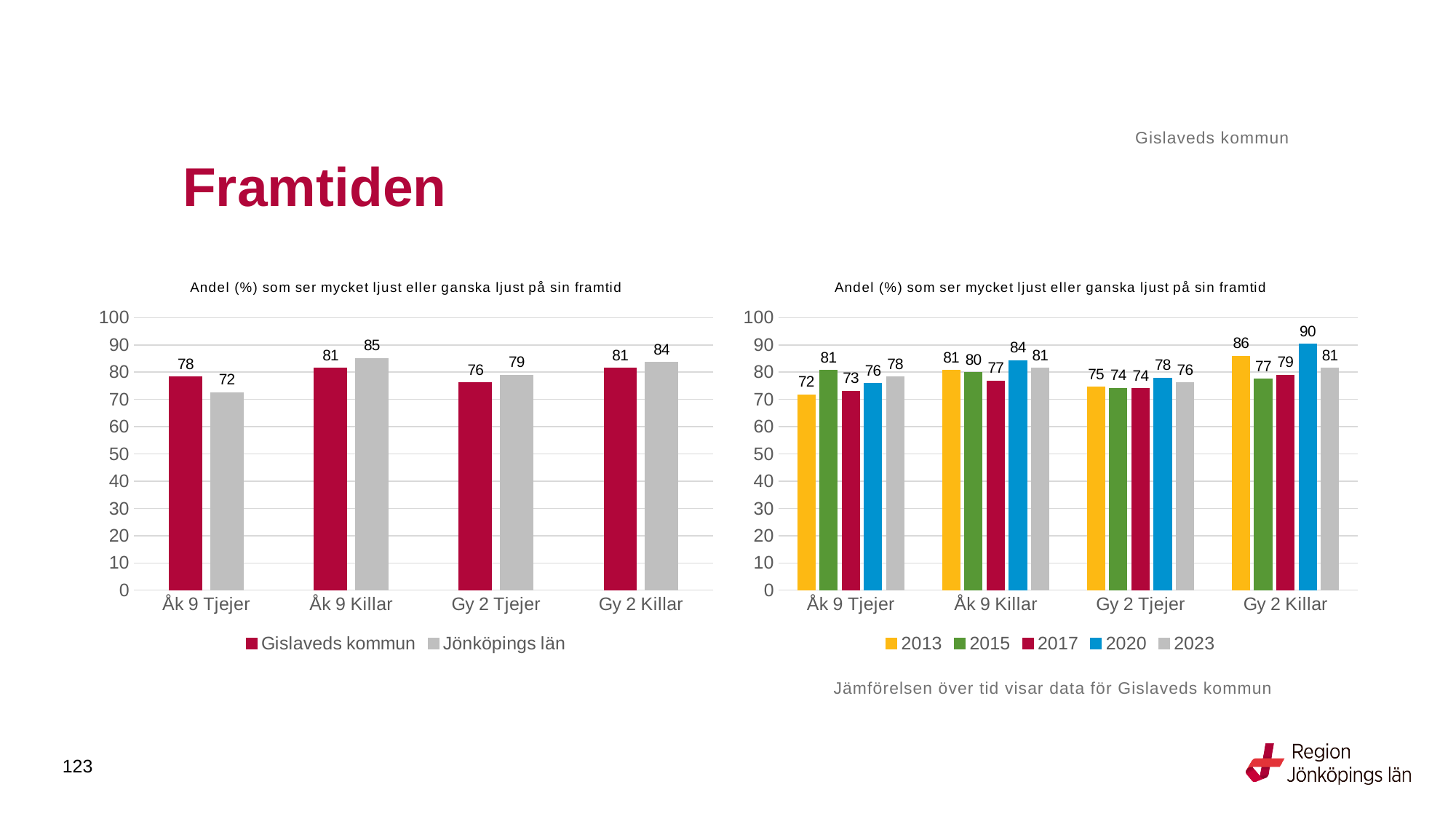
In the left chart, what is the value for Jönköpings län for Gy 2 Tjejer? 79 How many series does the legend of the right chart list? 5 How many series does the legend of the left chart list? 2 In the right chart, what is the value for 2020 for Gy 2 Killar? 90 In the right chart, what is the difference between the 2020 and 2013 values for Åk 9 Tjejer? 4 In the left chart, which category has the lowest value for Jönköpings län? Åk 9 Tjejer In the left chart, what is the value for Gislaveds kommun for Åk 9 Tjejer? 78 In the right chart, what is the value for 2013 for Åk 9 Tjejer? 72 What kind of chart is the right chart? Bar chart In the left chart, which is larger for Åk 9 Killar: Gislaveds kommun or Jönköpings län? Jönköpings län In the right chart, which year has the highest value for Gy 2 Killar? 2020 In the left chart, what is the difference between Jönköpings län and Gislaveds kommun for Åk 9 Tjejer? 6